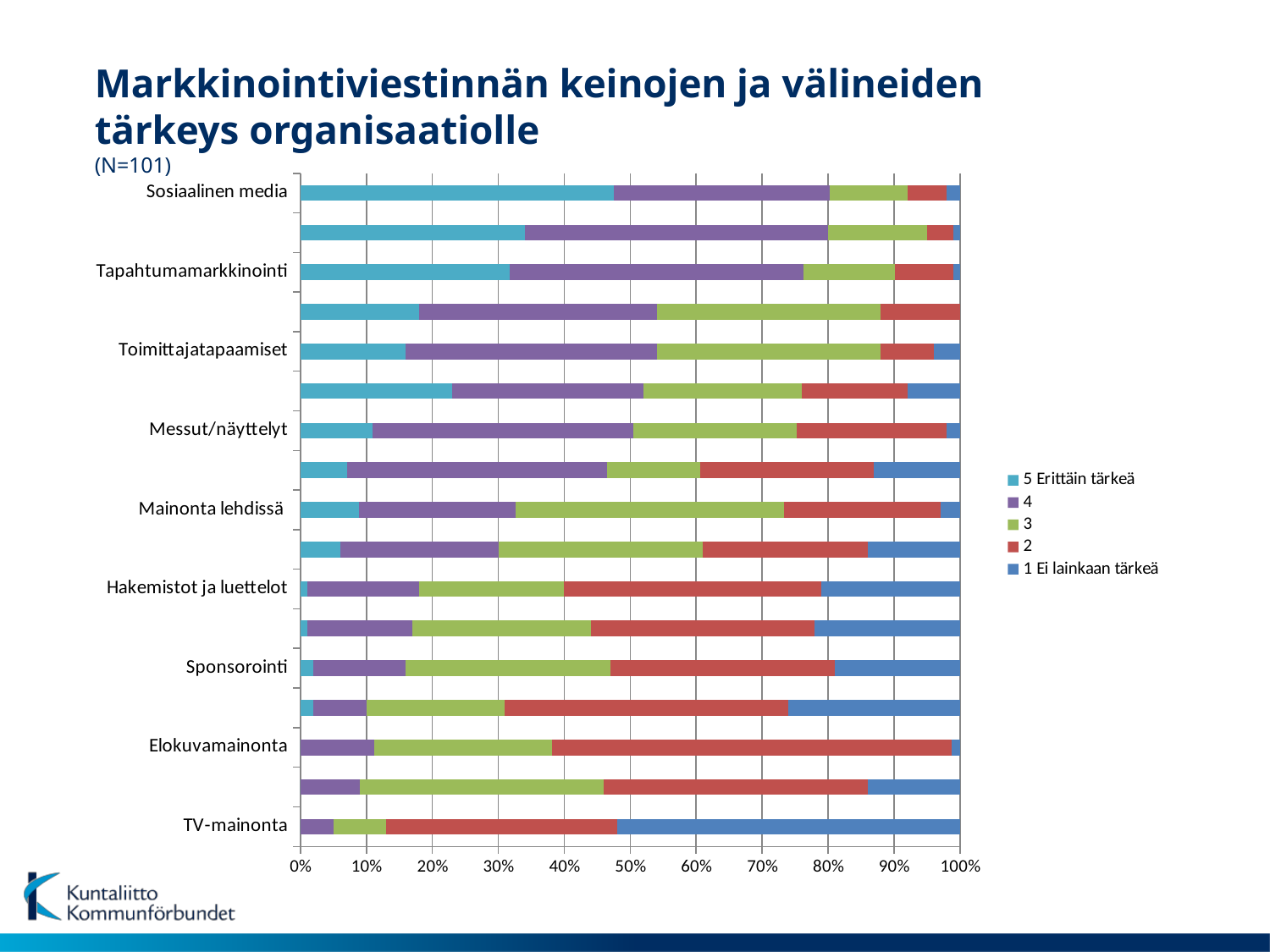
Which has a larger '2' share, Elokuvamainonta or TV-mainonta? Elokuvamainonta Is the '1 Ei lainkaan tärkeä' share for Hakemistot ja luettelot greater or less than 10%? greater Which category has the largest '1 Ei lainkaan tärkeä' share? TV-mainonta What sample size (N) is stated under the chart title? N=101 How many series does the legend list? 5 Is the '1 Ei lainkaan tärkeä' share for TV-mainonta greater or less than 40%? greater Which has a larger '5 Erittäin tärkeä' share, Tapahtumamarkkinointi or Messut/näyttelyt? Tapahtumamarkkinointi Is the '5 Erittäin tärkeä' share for Sosiaalinen media greater or less than 40%? greater What is the legend label for the series shown in light blue? 5 Erittäin tärkeä Which category has the largest '5 Erittäin tärkeä' share? Sosiaalinen media What kind of chart is shown on the slide? Stacked bar chart